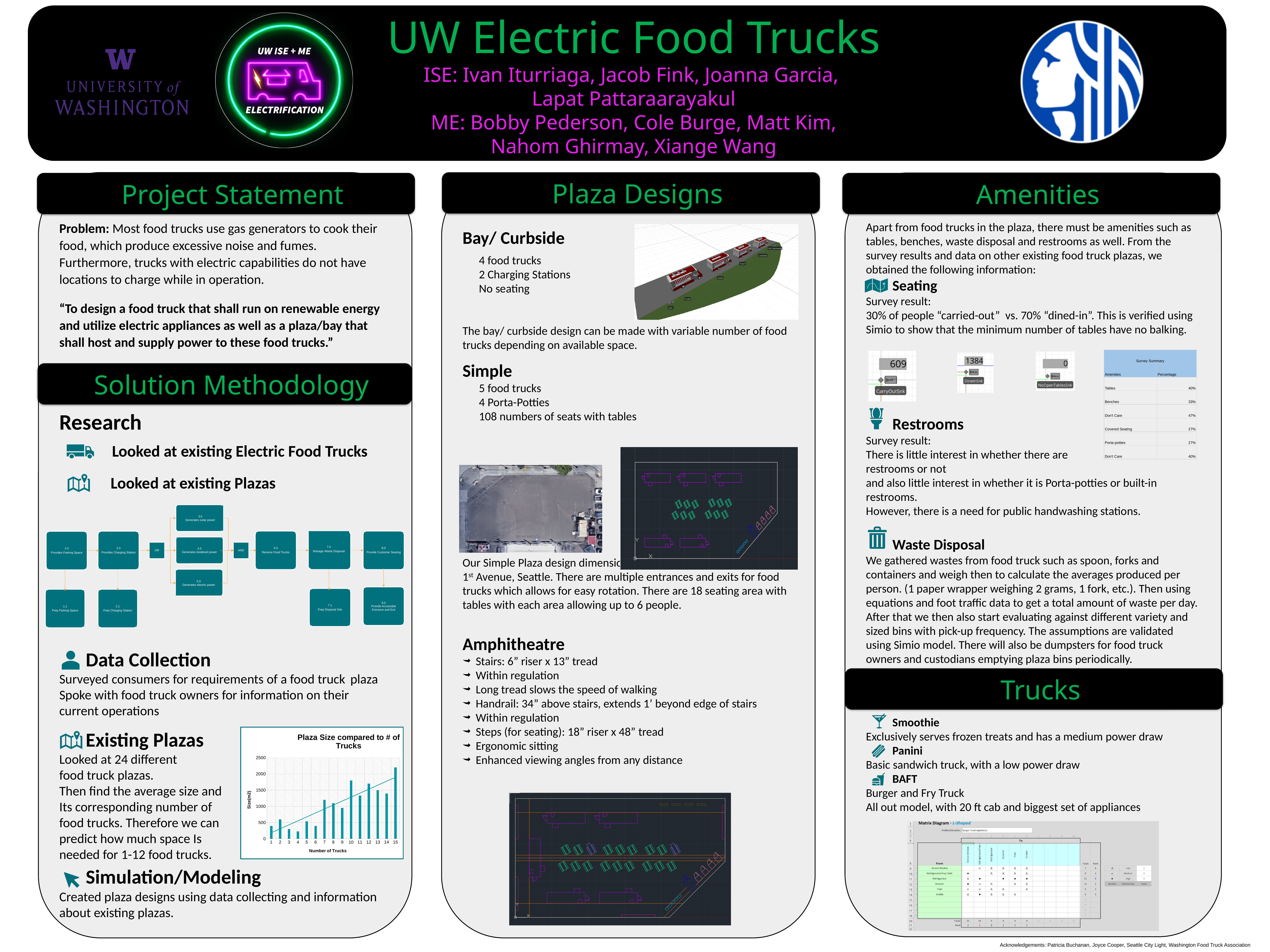
In the 'Plaza Size compared to # of Trucks' chart, is the value for 10 trucks greater or less than 1500? greater In the 'Plaza Size compared to # of Trucks' chart, which number of trucks has the largest plaza size? 15 In the 'Plaza Size compared to # of Trucks' chart, which is larger, the value for 10 trucks or the value for 9 trucks? 10 trucks In the 'Plaza Size compared to # of Trucks' chart, which is larger, the value for 15 trucks or the value for 1 truck? 15 trucks In the 'Plaza Size compared to # of Trucks' chart, do plaza sizes generally rise or fall as the number of trucks increases? rise In the 'Plaza Size compared to # of Trucks' chart, is the value for 7 trucks greater or less than 500? greater What is the y-axis label of the 'Plaza Size compared to # of Trucks' chart? Size(m2) What is the title of the bar chart in the Solution Methodology section? Plaza Size compared to # of Trucks In the 'Plaza Size compared to # of Trucks' chart, is the value for 4 trucks greater or less than 500? less What kind of chart is 'Plaza Size compared to # of Trucks'? bar chart How many bars (number-of-trucks categories) are plotted in the 'Plaza Size compared to # of Trucks' chart? 15